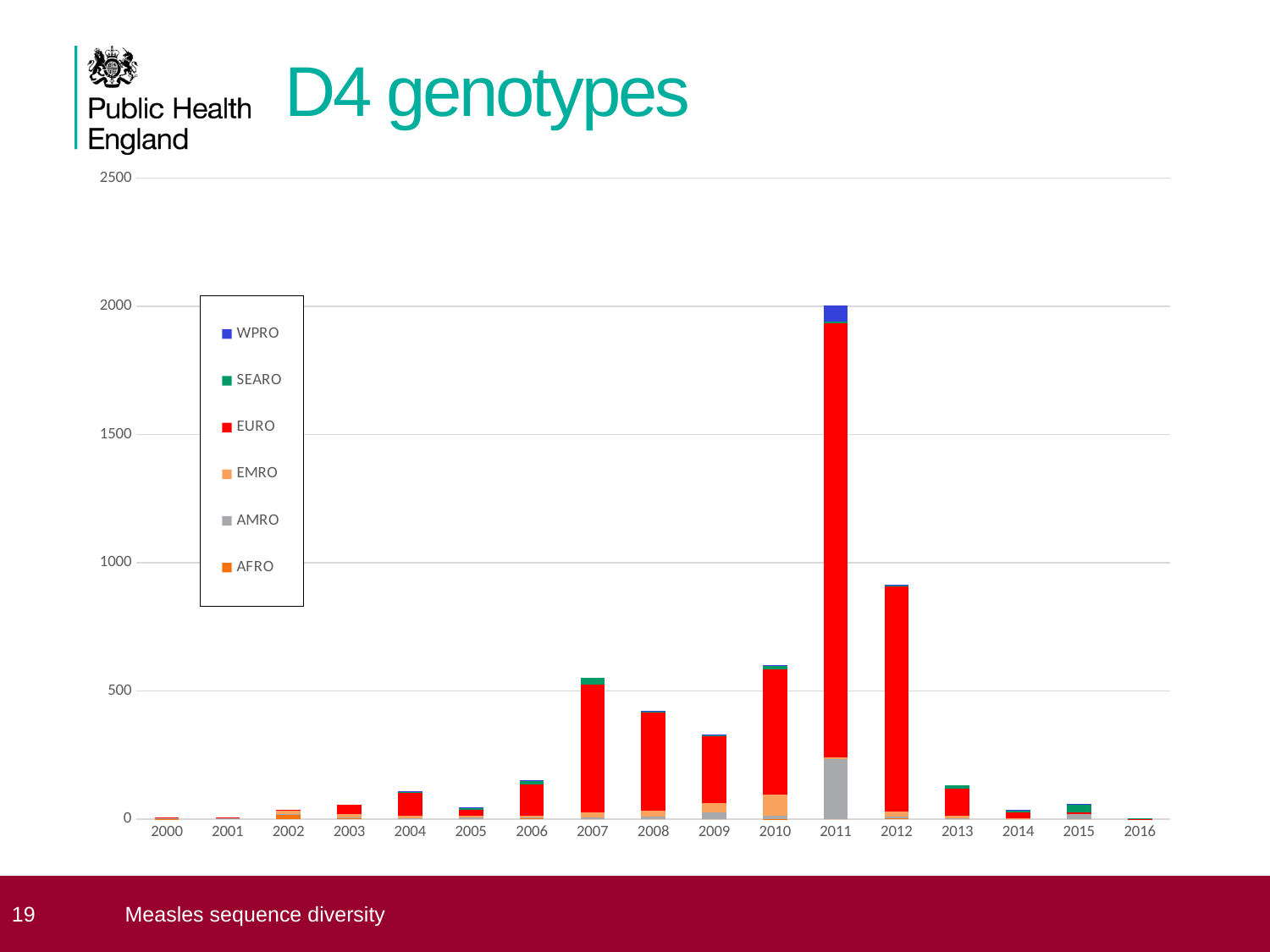
What is the title of the chart? D4 genotypes Is the total for 2009 greater or less than 500? less Is the total for 2007 greater or less than 500? greater How many years are shown along the x axis? 17 Which year has the larger total, 2011 or 2012? 2011 Is the total for 2012 greater or less than 1000? less Which year has the tallest bar? 2011 How many series does the legend list? 6 Which year has the larger total, 2007 or 2008? 2007 What kind of chart is shown on the slide? Stacked bar chart Which colour represents EURO in the legend? Red